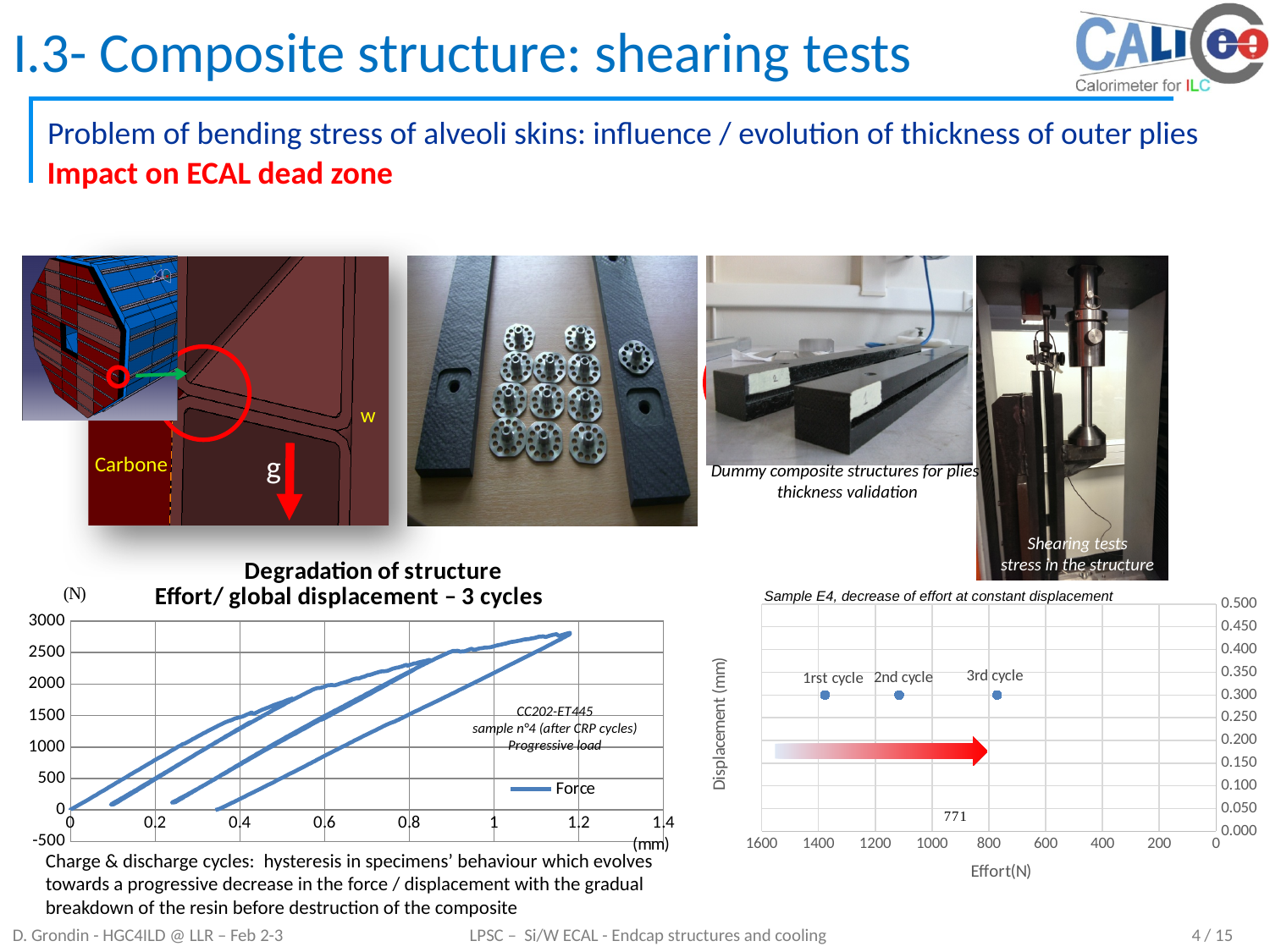
How many series does the legend of the left chart 'Effort/ global displacement – 3 cycles' list? 1 In the right chart 'Sample E4, decrease of effort at constant displacement', which cycle has the highest effort? 1rst cycle How many data points are plotted in the right chart 'Sample E4, decrease of effort at constant displacement'? 3 In the left chart 'Effort/ global displacement – 3 cycles', is the peak force reached greater or less than 2500? greater What kind of chart is the left chart titled 'Effort/ global displacement – 3 cycles'? line chart In the left chart 'Effort/ global displacement – 3 cycles', does the force rise or fall as displacement increases during loading? rise What kind of chart is the right chart titled 'Sample E4, decrease of effort at constant displacement'? scatter chart In the right chart 'Sample E4, decrease of effort at constant displacement', which cycle has the lowest effort? 3rd cycle What is the name of the series shown in the legend of the left chart 'Effort/ global displacement – 3 cycles'? Force In the right chart 'Sample E4, decrease of effort at constant displacement', is the effort for the 1rst cycle greater or less than 1200? greater What is the x-axis title of the right chart 'Sample E4, decrease of effort at constant displacement'? Effort(N) In the right chart 'Sample E4, decrease of effort at constant displacement', is the effort for the 3rd cycle greater or less than 1000? less